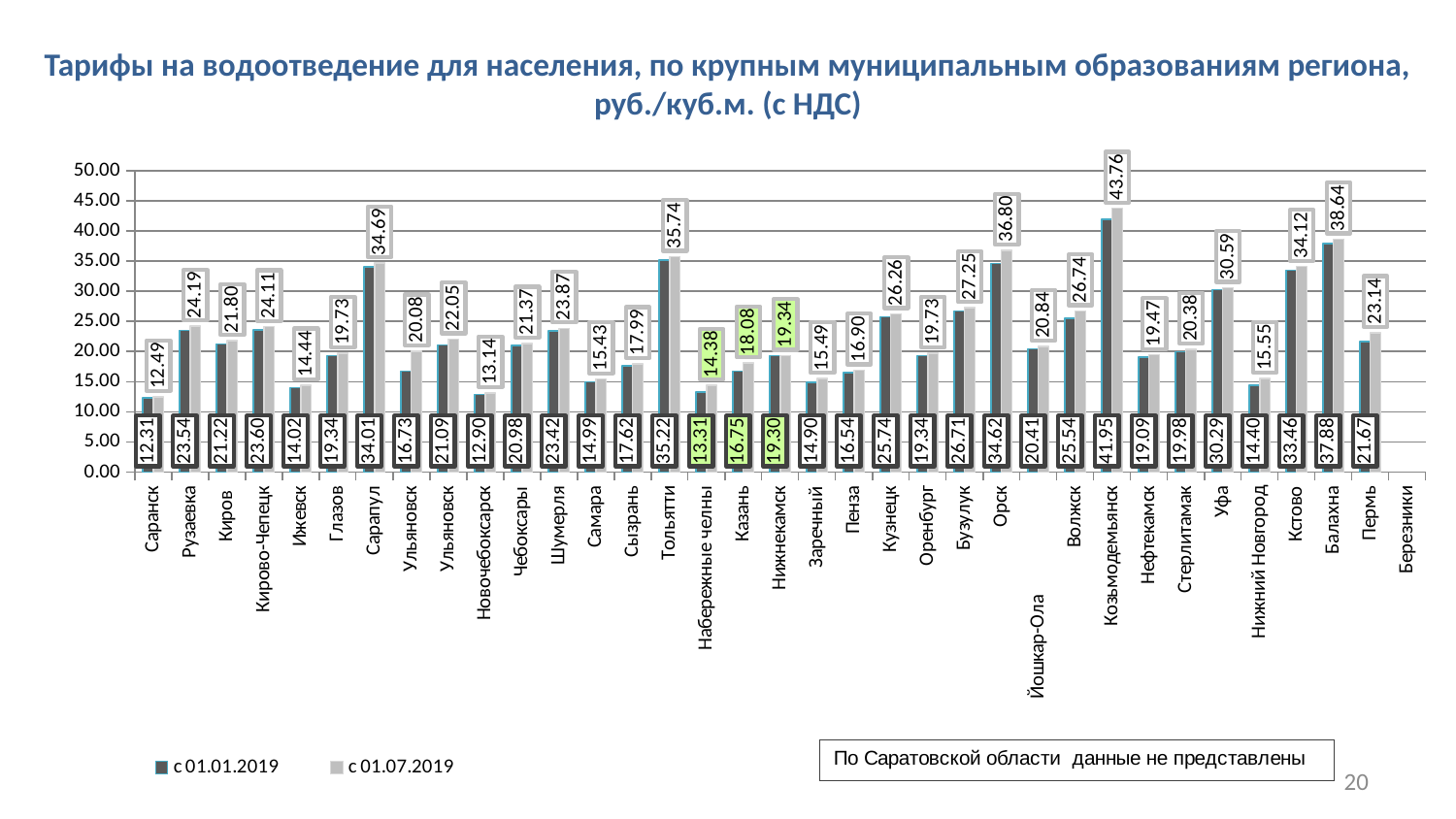
In the series 'с 01.01.2019', which is larger: Балахна or Кстово? Балахна What is the tariff for Козьмодемьянск in the series 'с 01.07.2019'? 43.76 What is the difference between the 'с 01.07.2019' and 'с 01.01.2019' values for Орск? 2.18 How many series does the legend list? 2 What is the tariff for Казань in the series 'с 01.01.2019'? 16.75 What is the value for Пермь in the series 'с 01.07.2019'? 23.14 According to the note on the slide, for which region is data not presented? Саратовская область What is the difference between the 'с 01.07.2019' and 'с 01.01.2019' values for Козьмодемьянск? 1.81 What type of chart is shown on the slide? Bar chart Which city has the highest tariff in the series 'с 01.07.2019'? Козьмодемьянск Is the value for Уфа in the series 'с 01.07.2019' greater or less than 30.00? greater Which city has the lowest tariff in the series 'с 01.01.2019'? Саранск